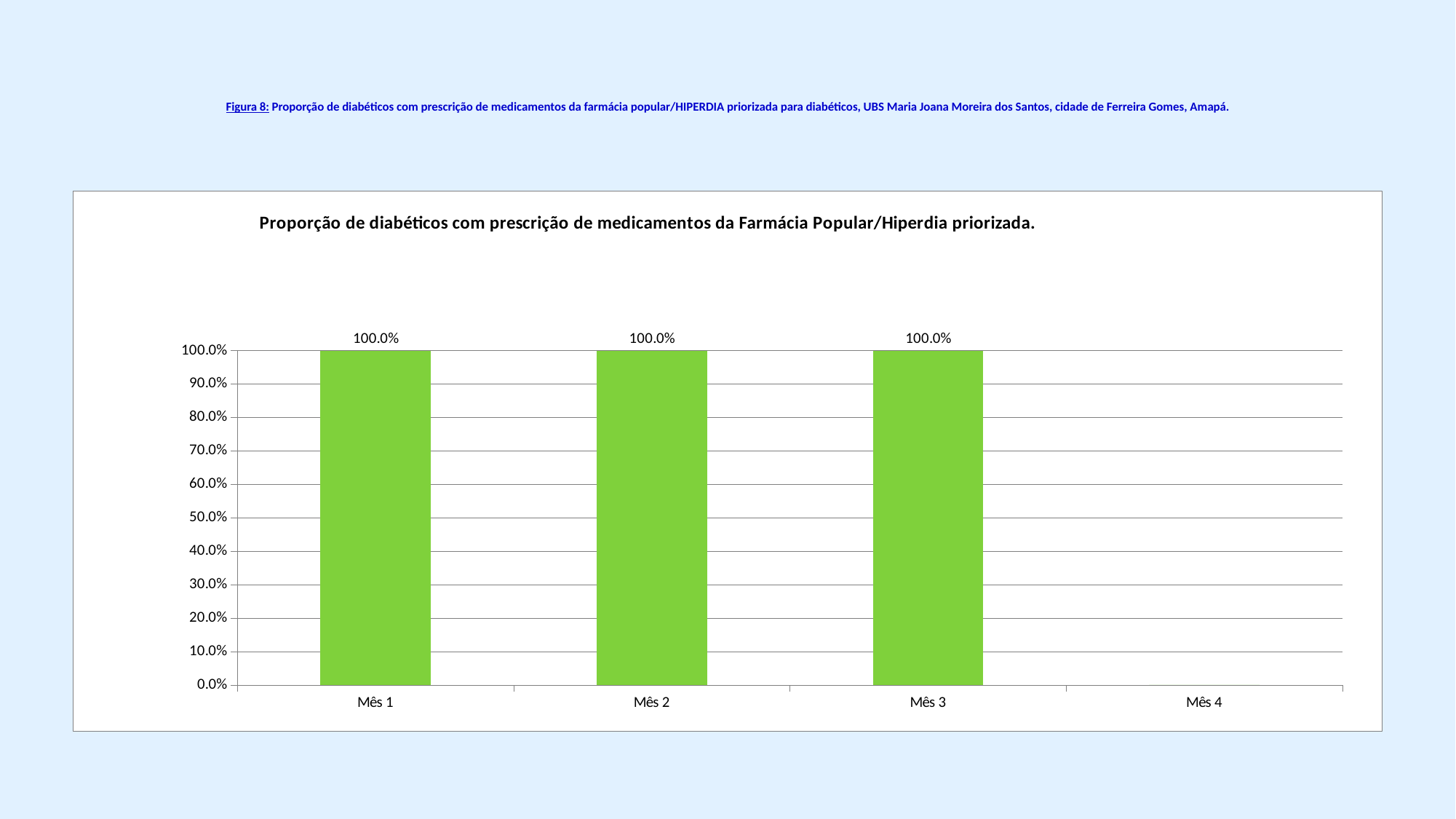
How many bars are plotted on the chart? 3 Do the values change from Mês 1 to Mês 3? No, they stay at 100.0% What kind of chart is shown on the slide? Bar chart Which category on the x axis has no bar plotted? Mês 4 What is the highest value shown on the y axis? 100.0% What is the value for Mês 1? 100.0% What is the value for Mês 2? 100.0% Is the value for Mês 2 greater or less than 50.0%? greater How many categories are shown on the x axis? 4 What is the value for Mês 3? 100.0% What is the difference between the values for Mês 1 and Mês 3? 0.0% What is the title of the chart? Proporção de diabéticos com prescrição de medicamentos da Farmácia Popular/Hiperdia priorizada.